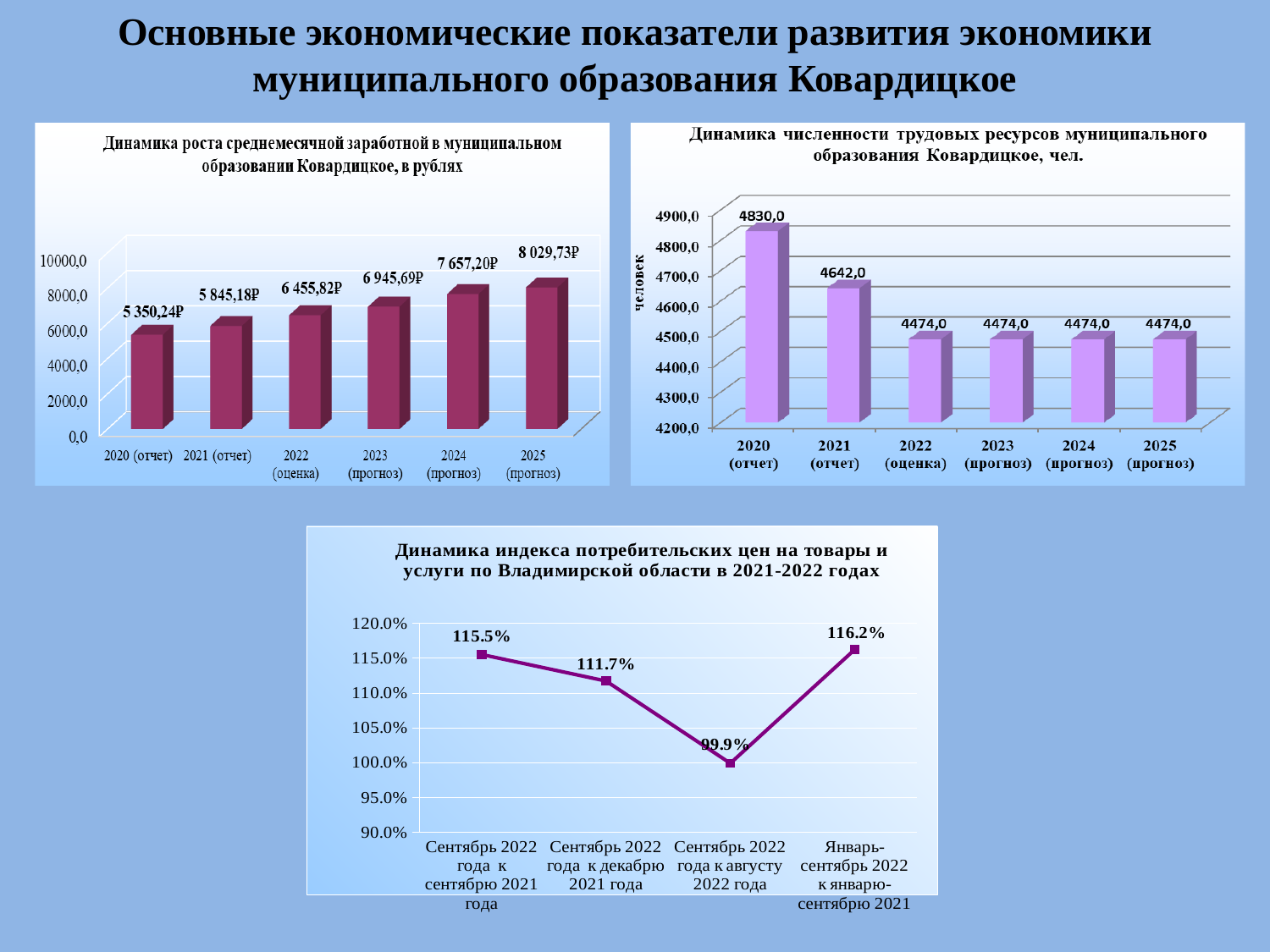
In the top-right chart (Динамика численности трудовых ресурсов), which year has the highest value? 2020 (отчет) In the top-left chart (Динамика роста среднемесячной заработной платы), what is the value for 2020 (отчет)? 5 350,24₽ In the top-right chart (Динамика численности трудовых ресурсов), what is the value for 2021 (отчет)? 4642,0 In the top-left chart (Динамика роста среднемесячной заработной платы), how many years are shown on the x axis? 6 In the top-right chart (Динамика численности трудовых ресурсов), what is the value for 2024 (прогноз)? 4474,0 In the top-left chart (Динамика роста среднемесячной заработной платы), do the values rise or fall from 2020 to 2025? rise What kind of chart is the bottom chart (Динамика индекса потребительских цен)? line chart In the top-right chart (Динамика численности трудовых ресурсов), what is the difference between the 2020 and 2021 values? 188,0 In the bottom chart (Динамика индекса потребительских цен), what is the value for Сентябрь 2022 года к августу 2022 года? 99.9% In the top-left chart (Динамика роста среднемесячной заработной платы), what is the value for 2025 (прогноз)? 8 029,73₽ In the bottom chart (Динамика индекса потребительских цен), which point has the highest value? Январь-сентябрь 2022 к январю-сентябрю 2021 In the bottom chart (Динамика индекса потребительских цен), what is the difference between the first point (115.5%) and the last point (116.2%)? 0.7%